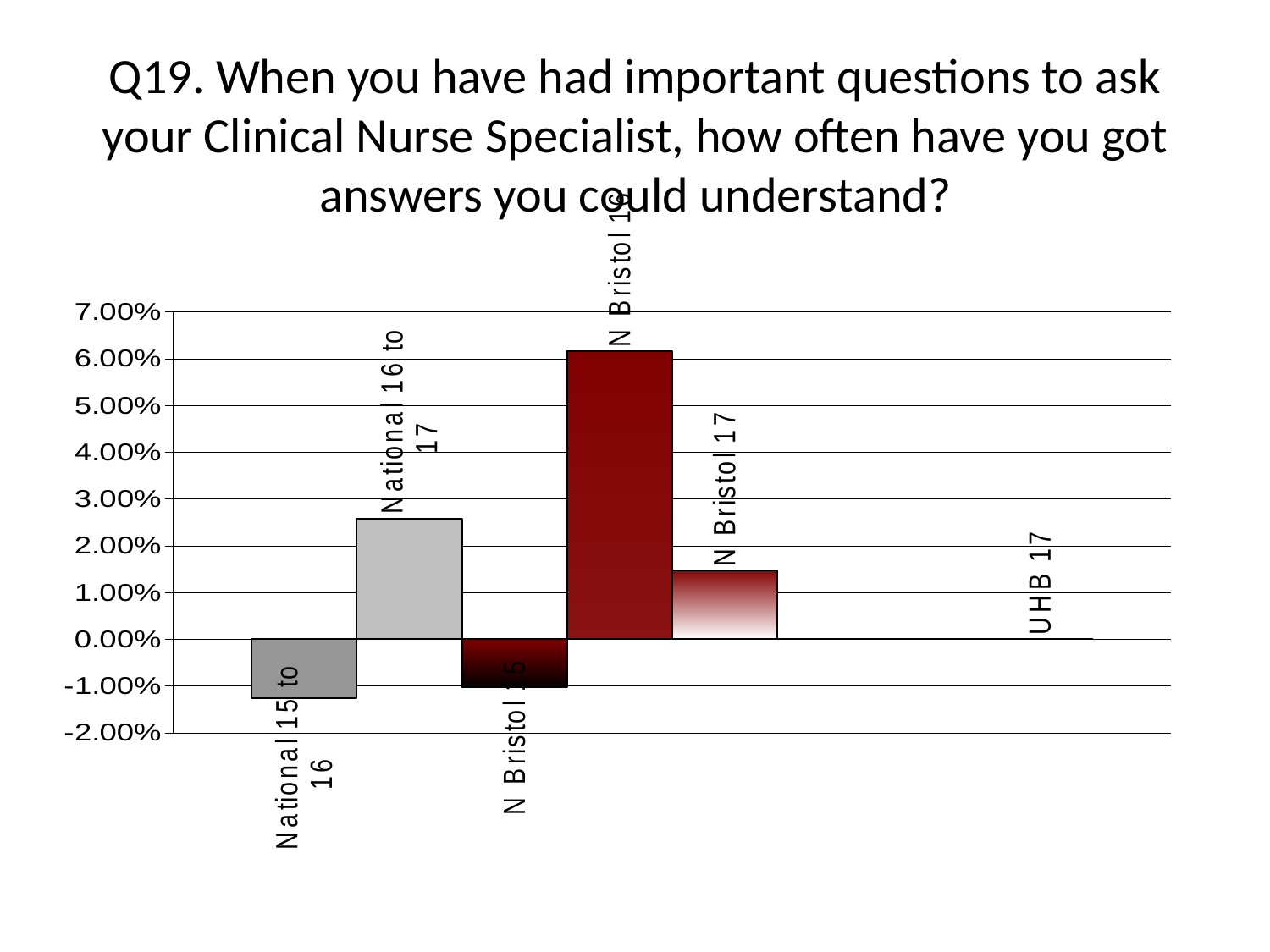
What kind of chart is shown on the slide? bar chart Is the value for N Bristol 17 greater or less than 1.00%? greater Is the value for National 16 to 17 greater or less than 3.00%? less Is the value for N Bristol 15 greater or less than 0.00%? less Which is larger, the value for National 16 to 17 or the value for N Bristol 17? National 16 to 17 How many categories are shown on the x axis of the chart? 6 What is the question number shown at the start of the chart title? Q19 Which category has the highest value in the chart? N Bristol 16 Which is larger, the value for N Bristol 16 or the value for National 16 to 17? N Bristol 16